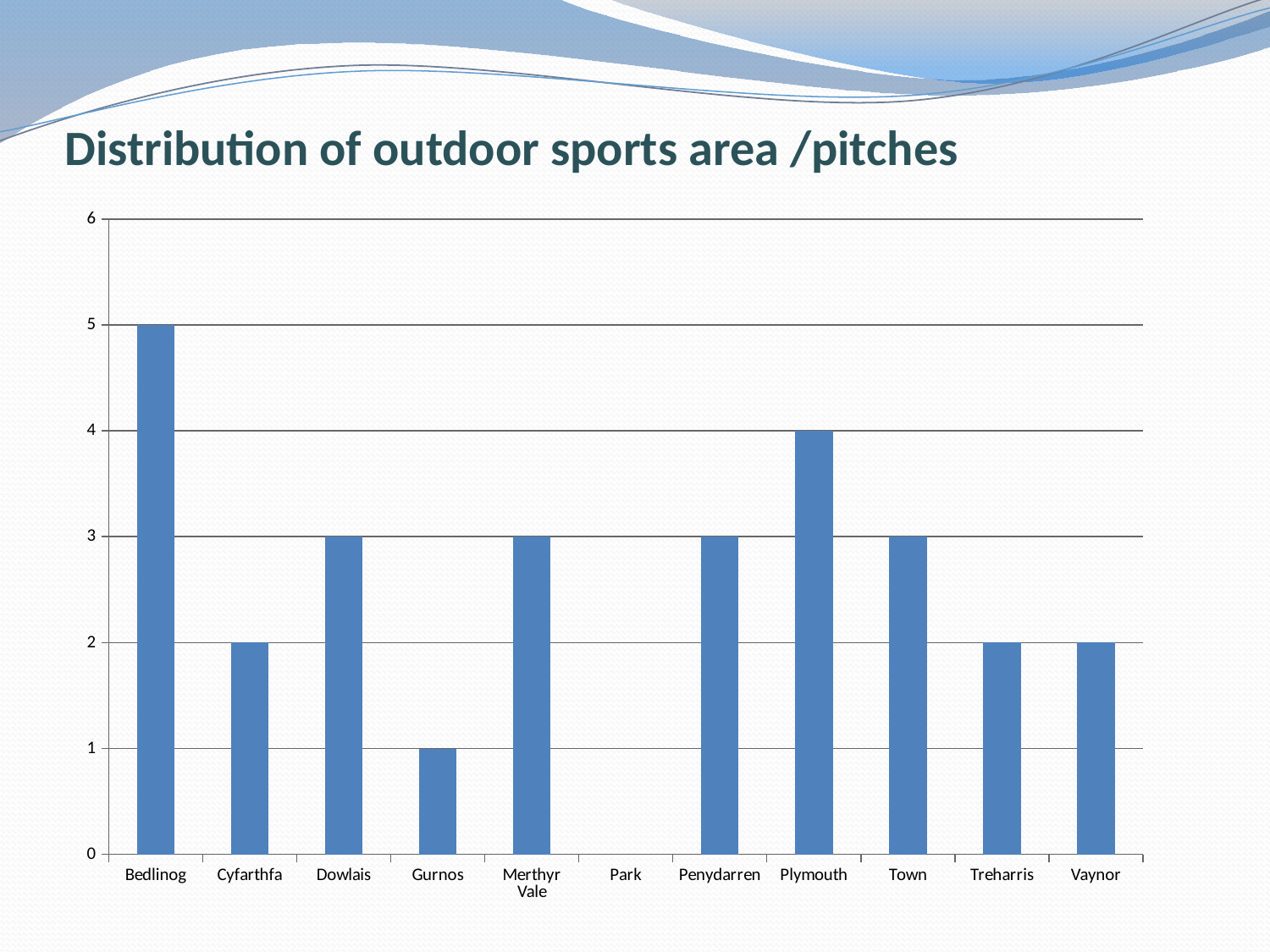
Which category has the shortest plotted bar? Gurnos Which is larger, the value for Plymouth or the value for Dowlais? Plymouth What is the difference between the values for Bedlinog and Plymouth? 1 What type of chart is shown on the slide? Bar chart Which category has the highest value? Bedlinog What is the value for Gurnos? 1 What is the value for Bedlinog? 5 How many categories are shown on the x axis? 11 Which category has no bar plotted at all? Park What is the title of the chart? Distribution of outdoor sports area /pitches What is the value for Treharris? 2 What is the value for Plymouth? 4